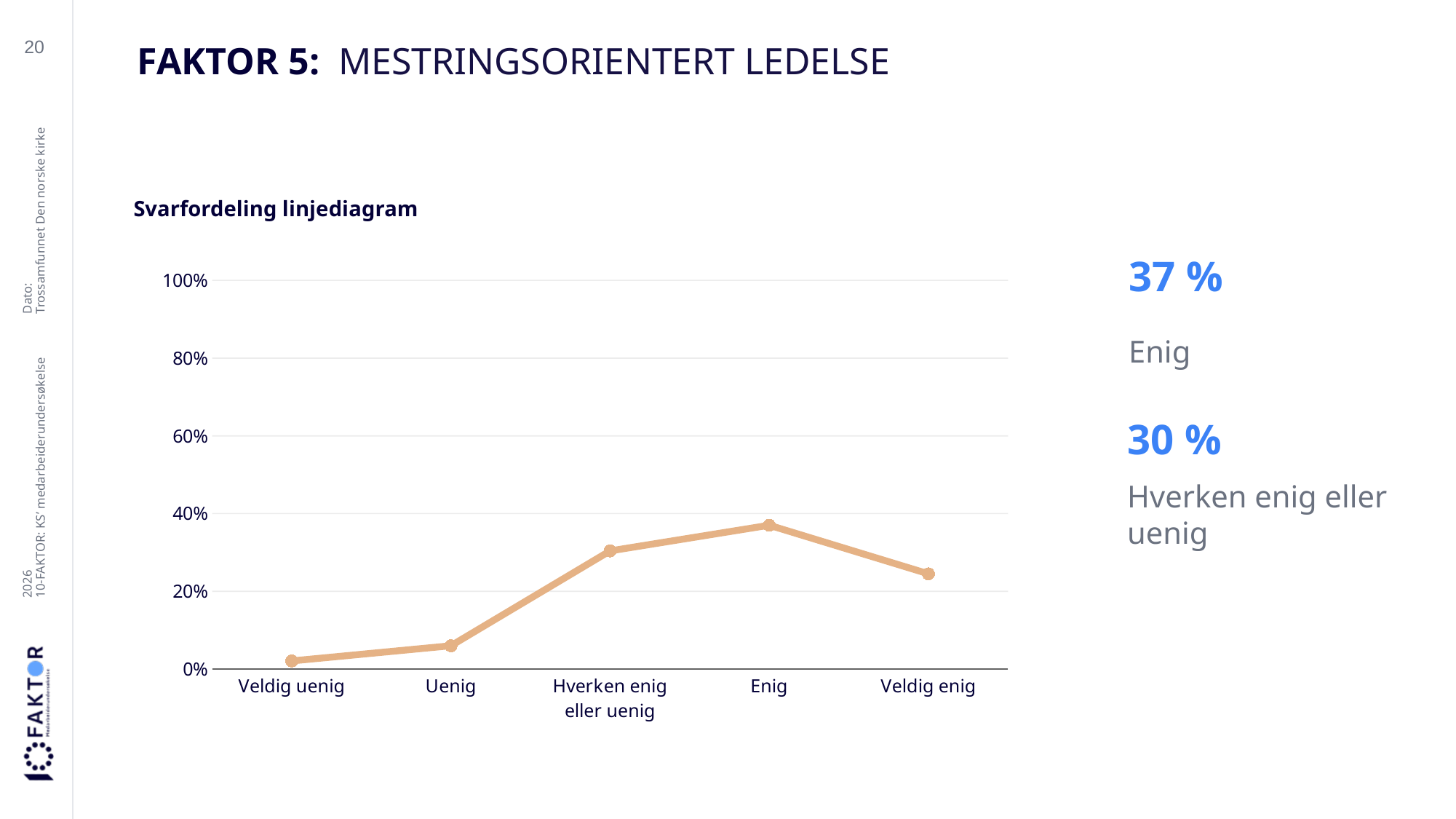
What is the difference between the values for Enig and Hverken enig eller uenig? 7 % Is the value for Veldig enig greater or less than 20%? greater Do the values rise or fall from Veldig uenig to Enig along the x axis? rise How many categories are plotted on the x axis? 5 Which is larger, the value for Veldig enig or the value for Uenig? Veldig enig What is the title of the chart? Svarfordeling linjediagram Which category has the lowest value? Veldig uenig What is the value for Hverken enig eller uenig? 30 % What is the value for Enig? 37 % What kind of chart is shown on the slide? line chart Is the value for Uenig greater or less than 20%? less Which category has the highest value? Enig